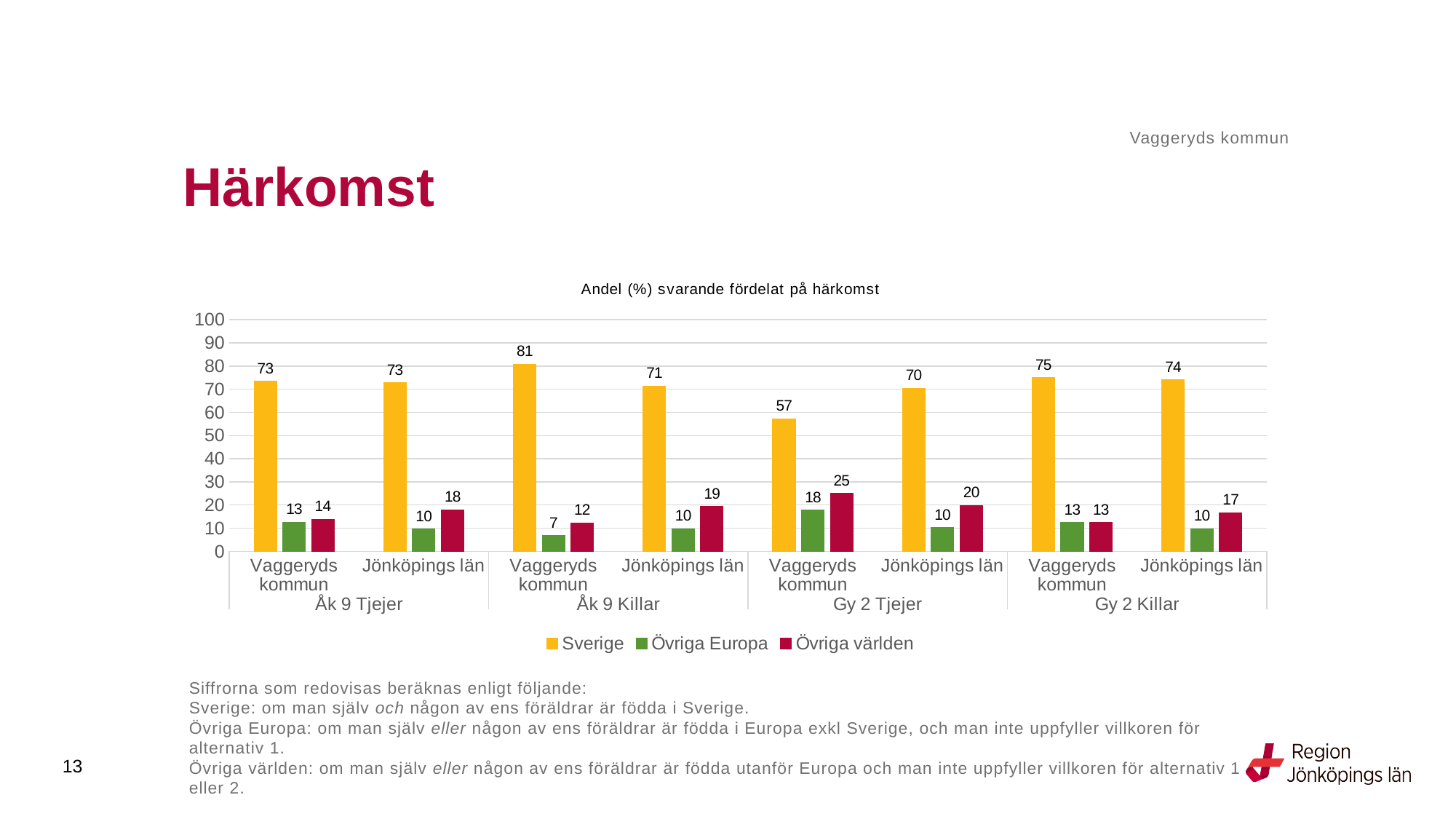
Which is larger: the Övriga världen value for Vaggeryds kommun in Gy 2 Tjejer or in Gy 2 Killar? Gy 2 Tjejer Which group has the highest Sverige value? Vaggeryds kommun, Åk 9 Killar What is the title of the chart? Andel (%) svarande fördelat på härkomst What is the difference between the Sverige values for Vaggeryds kommun and Jönköpings län in the Åk 9 Killar group? 10 What is the value for Övriga Europa for Jönköpings län in the Åk 9 Tjejer group? 10 How many groups of bars are shown along the x axis? 8 What is the value for Sverige for Vaggeryds kommun in the Åk 9 Killar group? 81 What kind of chart is shown on the slide? Bar chart Which colour represents the Övriga Europa series? Green What is the value for Övriga världen for Vaggeryds kommun in the Gy 2 Tjejer group? 25 How many series does the legend list? 3 Which group has the lowest Sverige value? Vaggeryds kommun, Gy 2 Tjejer